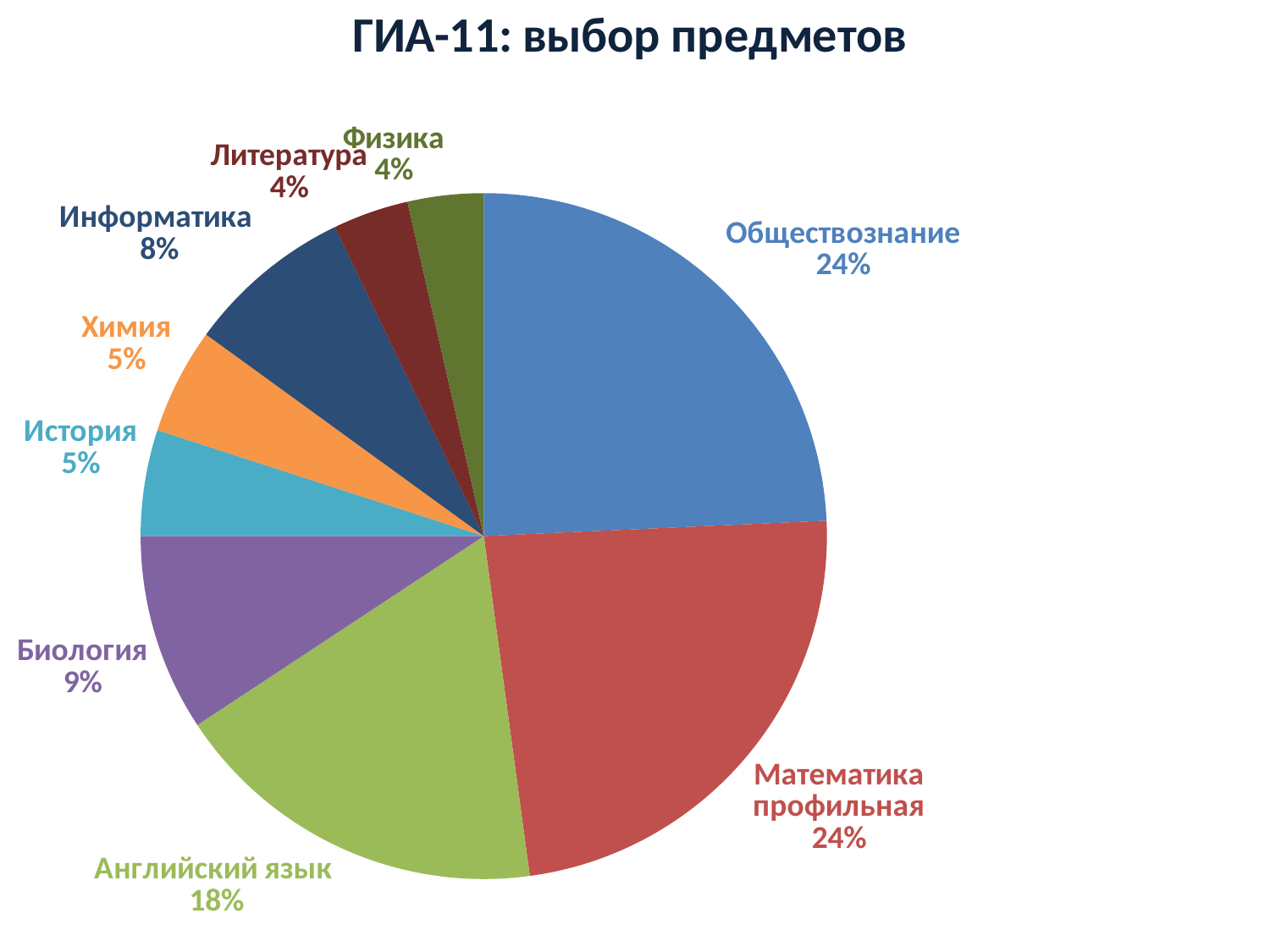
What is the value shown for Химия? 5% What share of the pie does Английский язык have? 18% What is the difference between the shares of Обществознание and Английский язык? 6% What is the value shown for Информатика? 8% Which has a larger share, Биология or Информатика? Биология What is the title of the chart? ГИА-11: выбор предметов What is the value shown for Математика профильная? 24% What is the difference between the shares of Информатика and Физика? 4% Which has a larger share, Английский язык or История? Английский язык How many slices does the pie chart have? 9 What is the value shown for Биология? 9% What type of chart is shown on the slide? pie chart